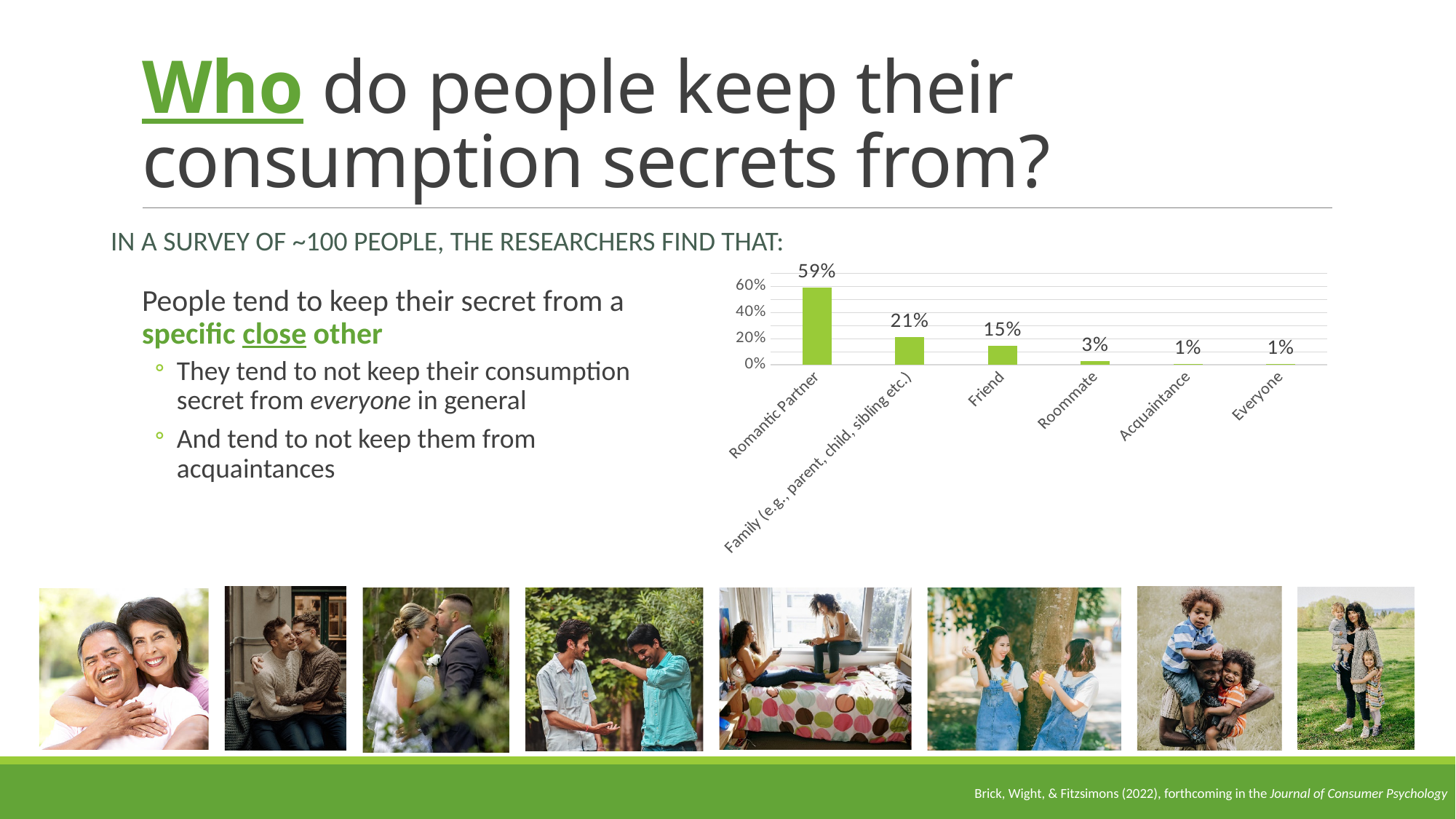
What is the value shown for Family (e.g., parent, child, sibling etc.)? 21% Which category has the highest value in the chart? Romantic Partner Do the values rise or fall moving from left to right along the x axis? Fall Which is larger, the value for Friend or the value for Roommate? Friend What is the difference between the values for Family and Friend? 6% What percentage of people keep their consumption secret from a Romantic Partner? 59% What is the value shown for Friend? 15% What is the value shown for Roommate? 3% How many categories are shown on the x axis of the chart? 6 What is the difference between the values for Romantic Partner and Family? 38% What kind of chart is shown on the slide? Bar chart Is the value for Romantic Partner greater or less than 40%? greater